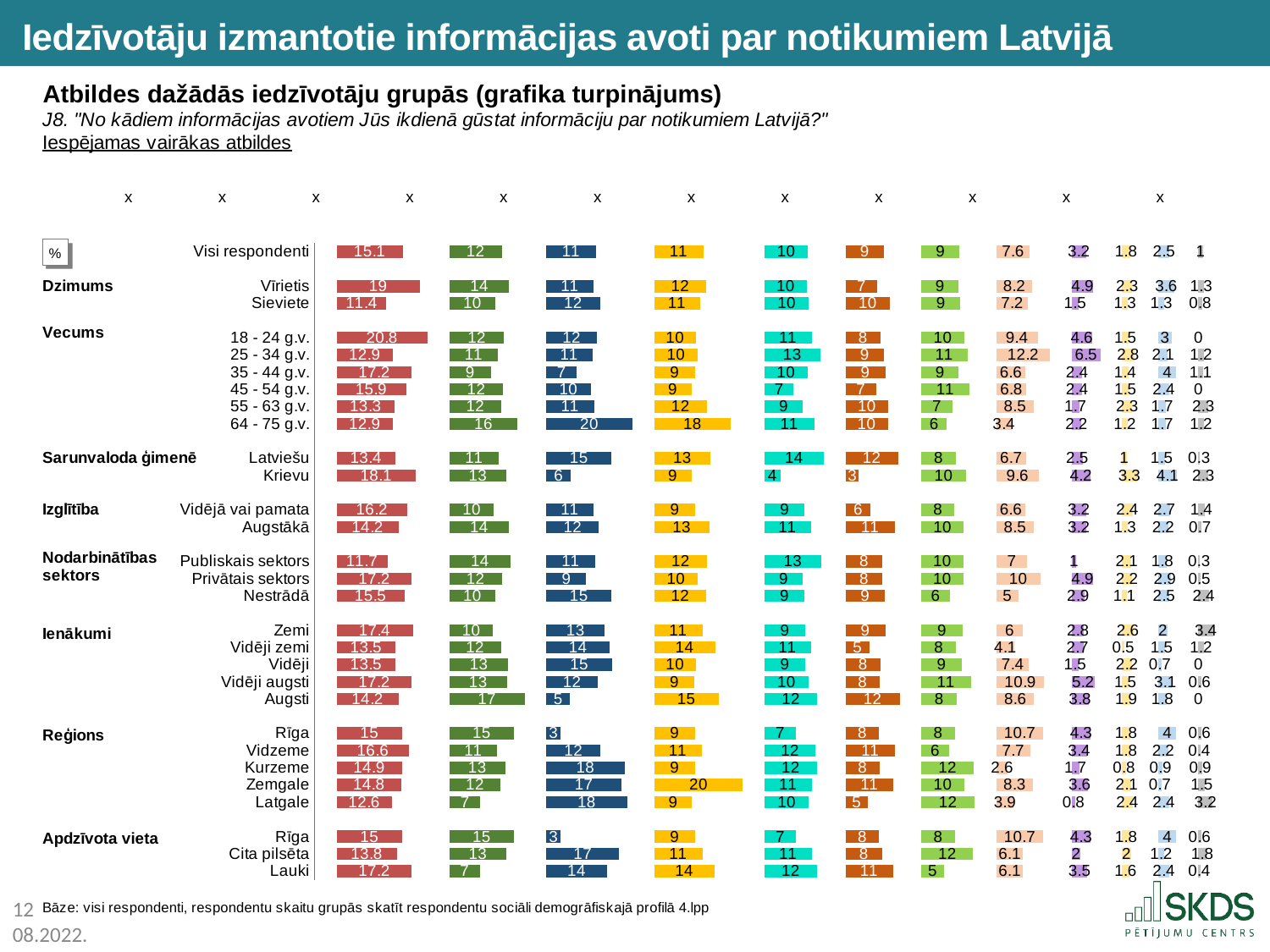
In the third (blue) bar series, which age group (Vecums) has the highest value? 64 - 75 g.v. In the first (red) bar series, which region (Reģions) has the lowest value? Latgale In the second (green) bar series, what is the value for 64 - 75 g.v.? 16 In the first (red) bar series, what is the value for Visi respondenti? 15.1 In the first (red) bar series, what is the value for Vīrietis? 19 In the first (red) bar series, which is larger: the value for Latviešu or for Krievu? Krievu What kind of chart is used on this slide? Bar chart In the first (red) bar series, which age group (Vecums) has the highest value? 18 - 24 g.v. How many age groups are listed under Vecums? 6 In the first (red) bar series, what is the difference between the values for Vīrietis and Sieviete? 7.6 In the fourth (yellow) bar series, what is the value for Zemgale? 20 In the third (blue) bar series, what is the value for Rīga under Reģions? 3